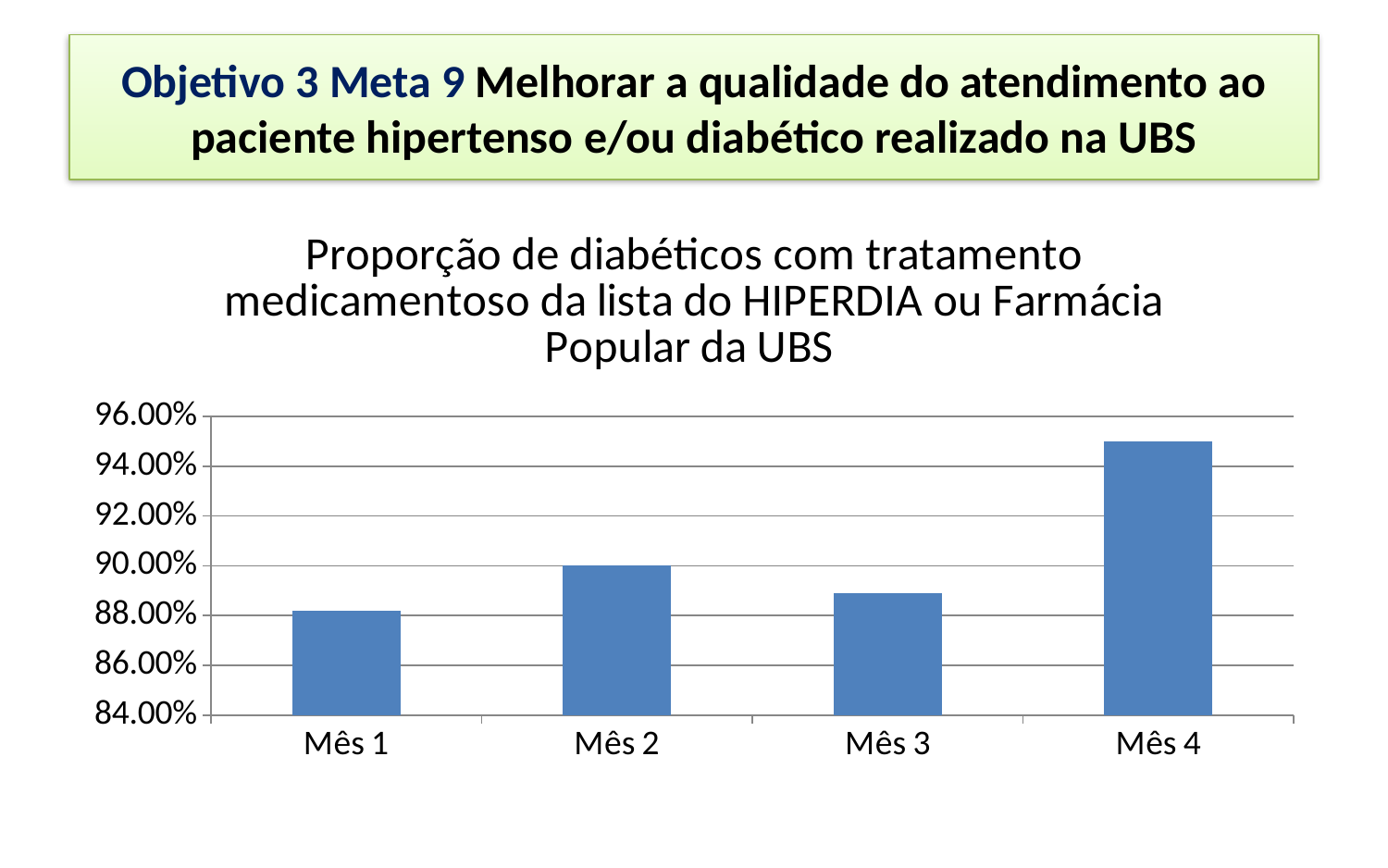
Is the value for Mês 4 greater or less than 94.00%? greater Is the value for Mês 3 greater or less than 90.00%? less Which month has the lowest proportion of diabetics with medication treatment? Mês 1 Which is larger, the value for Mês 4 or the value for Mês 1? Mês 4 Is the value for Mês 2 greater or less than 88.00%? greater Which is larger, the value for Mês 2 or the value for Mês 3? Mês 2 What kind of chart is shown on the slide? bar chart Which month has the highest proportion of diabetics with medication treatment? Mês 4 How many months (categories) are plotted on the chart? 4 What is the title of the chart? Proporção de diabéticos com tratamento medicamentoso da lista do HIPERDIA ou Farmácia Popular da UBS